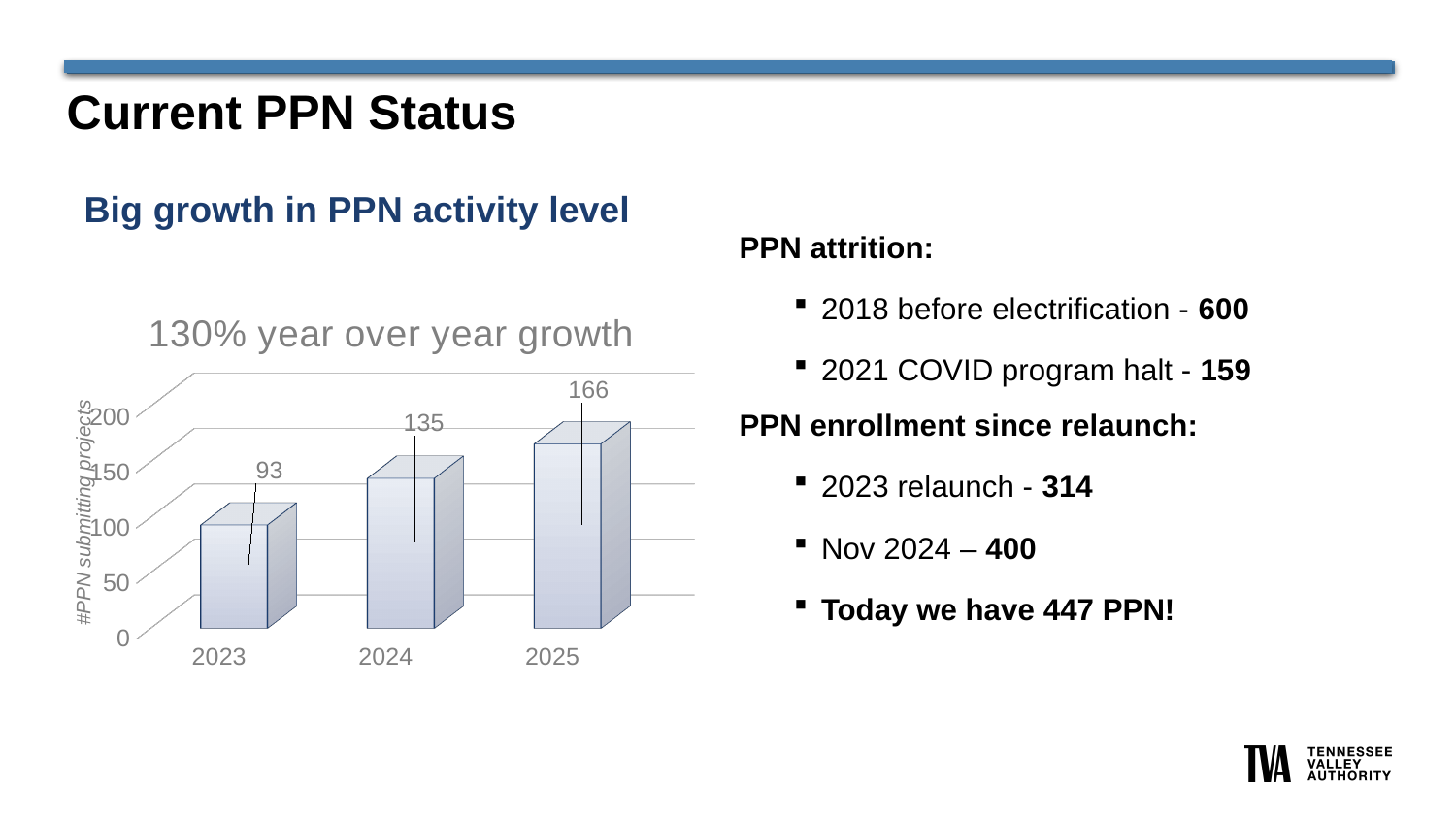
What is the difference between the values for 2025 and 2023? 73 What is the value for 2024 in the chart? 135 What is the title of the chart? 130% year over year growth Which is larger, the value for 2024 or the value for 2025? 2025 What is the difference between the values for 2024 and 2023? 42 Which year has the highest value in the chart? 2025 Which year has the lowest value in the chart? 2023 What kind of chart is shown on the slide? bar chart What is the value for 2023 in the chart? 93 How many years are shown on the x axis of the chart? 3 Is the value for 2023 greater or less than 100? less What is the value for 2025 in the chart? 166